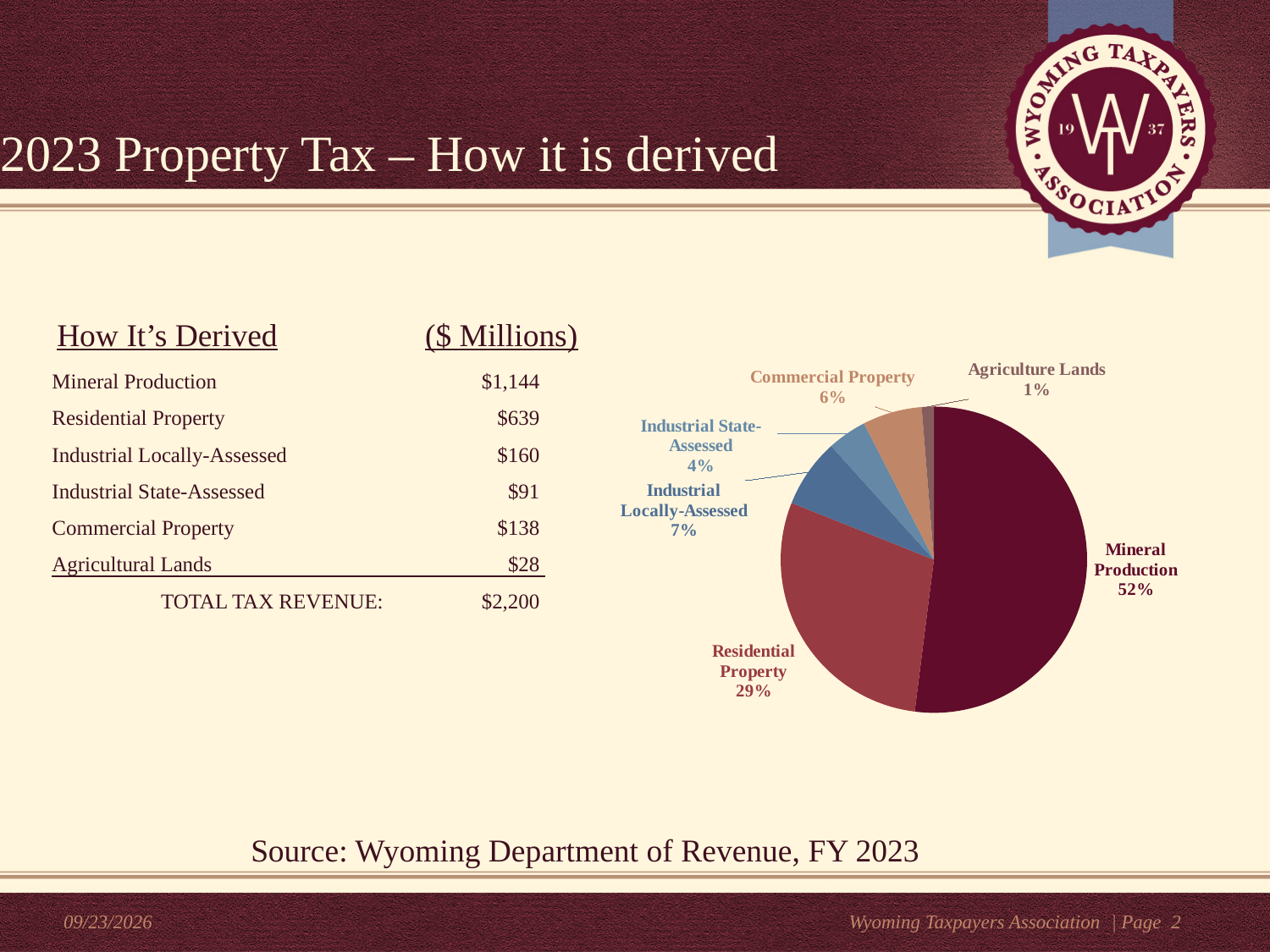
What percentage is shown for Agriculture Lands in the pie chart? 1% What percentage is shown for Industrial Locally-Assessed in the pie chart? 7% What share of the pie does Residential Property represent? 29% What is the difference in percentage points between Mineral Production and Residential Property in the pie chart? 23 What percentage is shown for Industrial State-Assessed in the pie chart? 4% Which category has the smallest slice of the pie chart? Agriculture Lands How many slices does the pie chart have? 6 Which category has the largest slice of the pie chart? Mineral Production What percentage is shown for Commercial Property in the pie chart? 6% What share of the pie does Mineral Production represent? 52% What type of chart is shown on the slide? pie chart Which slice is larger in the pie chart, Commercial Property or Industrial State-Assessed? Commercial Property